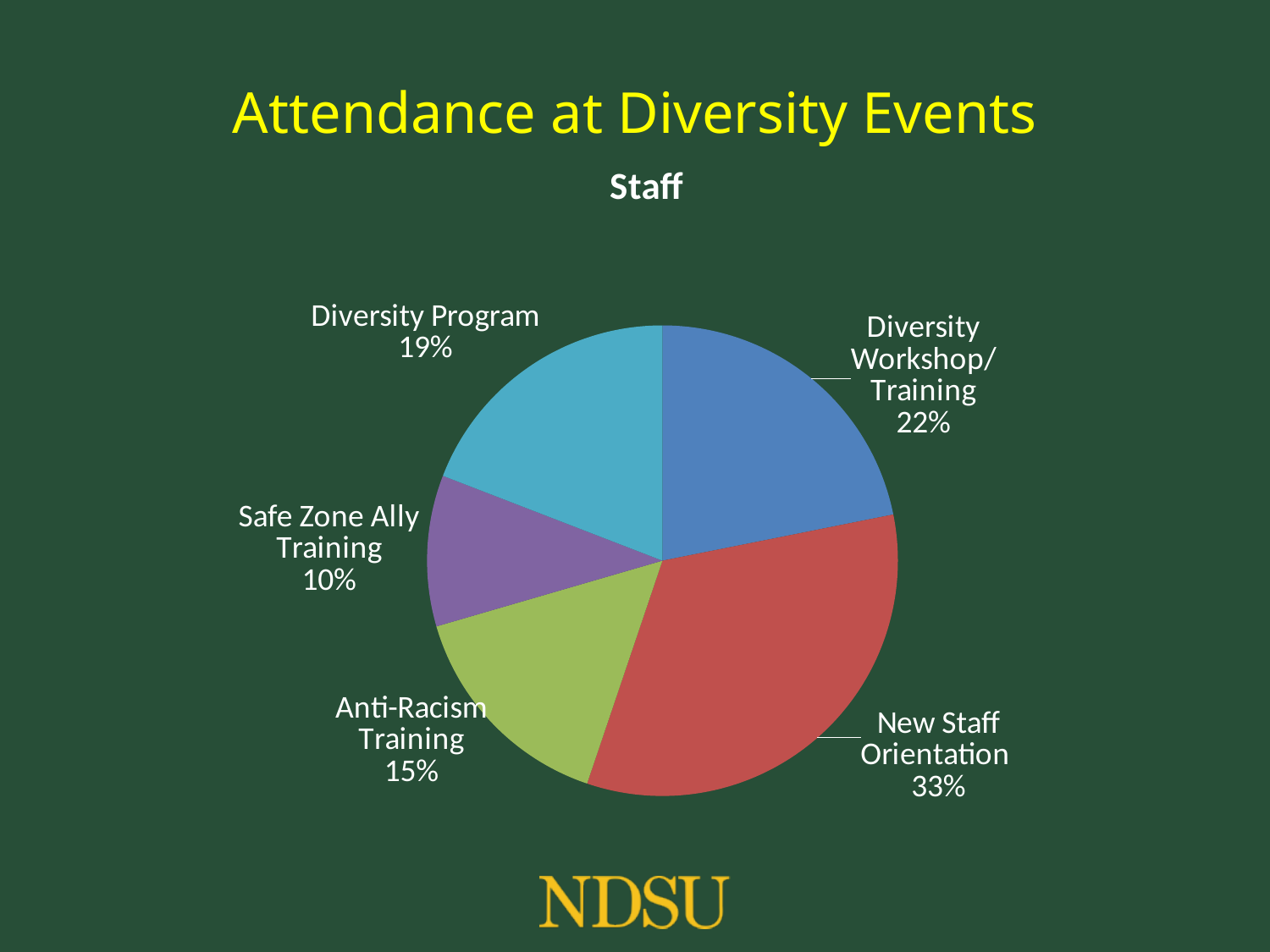
Which is larger, the share for Diversity Program or the share for Anti-Racism Training? Diversity Program What percentage of staff attendance is for Diversity Workshop/Training? 22% What colour is the slice for New Staff Orientation? red What percentage of staff attendance is for Safe Zone Ally Training? 10% What is the difference in percentage points between New Staff Orientation and Diversity Program? 14 What is the chart's title? Staff What percentage of staff attendance is for Anti-Racism Training? 15% Which category has the smallest share of the pie? Safe Zone Ally Training What kind of chart is shown on the slide? pie chart Which category has the largest share of the pie? New Staff Orientation What percentage of staff attendance is for New Staff Orientation? 33% How many categories are shown in the pie chart? 5